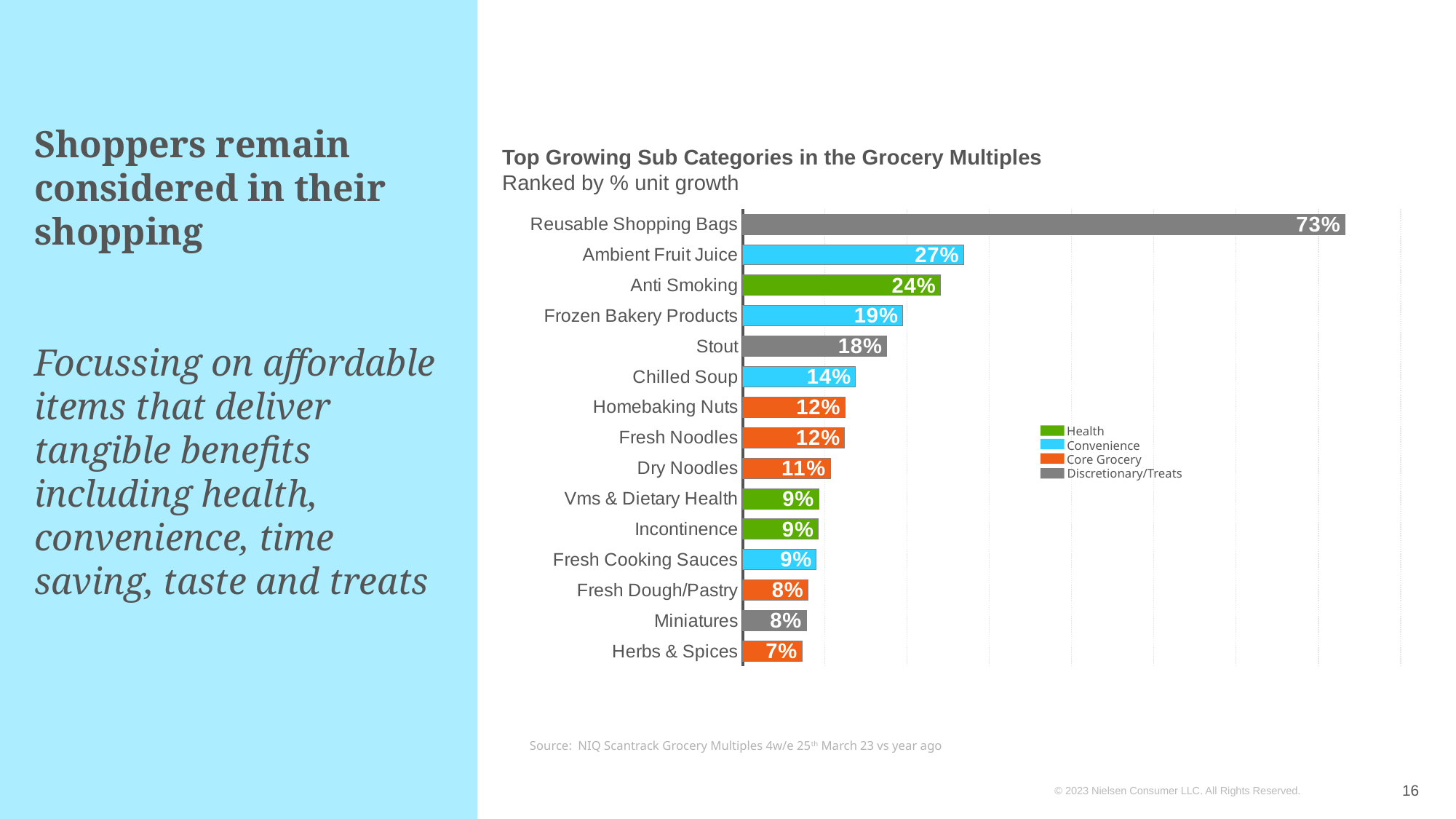
Which legend category does the colour of the Homebaking Nuts bar represent? Core Grocery Which has higher % unit growth, Stout or Dry Noodles? Stout How many sub categories are shown in the chart? 15 Which sub category has the lowest % unit growth? Herbs & Spices What is the % unit growth for Reusable Shopping Bags? 73% Which sub category has the highest % unit growth? Reusable Shopping Bags How many series does the legend list? 4 What is the % unit growth for Chilled Soup? 14% What kind of chart is shown on the slide? Bar chart What is the difference in % unit growth between Ambient Fruit Juice and Frozen Bakery Products? 8% What is the title of the chart? Top Growing Sub Categories in the Grocery Multiples What is the % unit growth for Anti Smoking? 24%